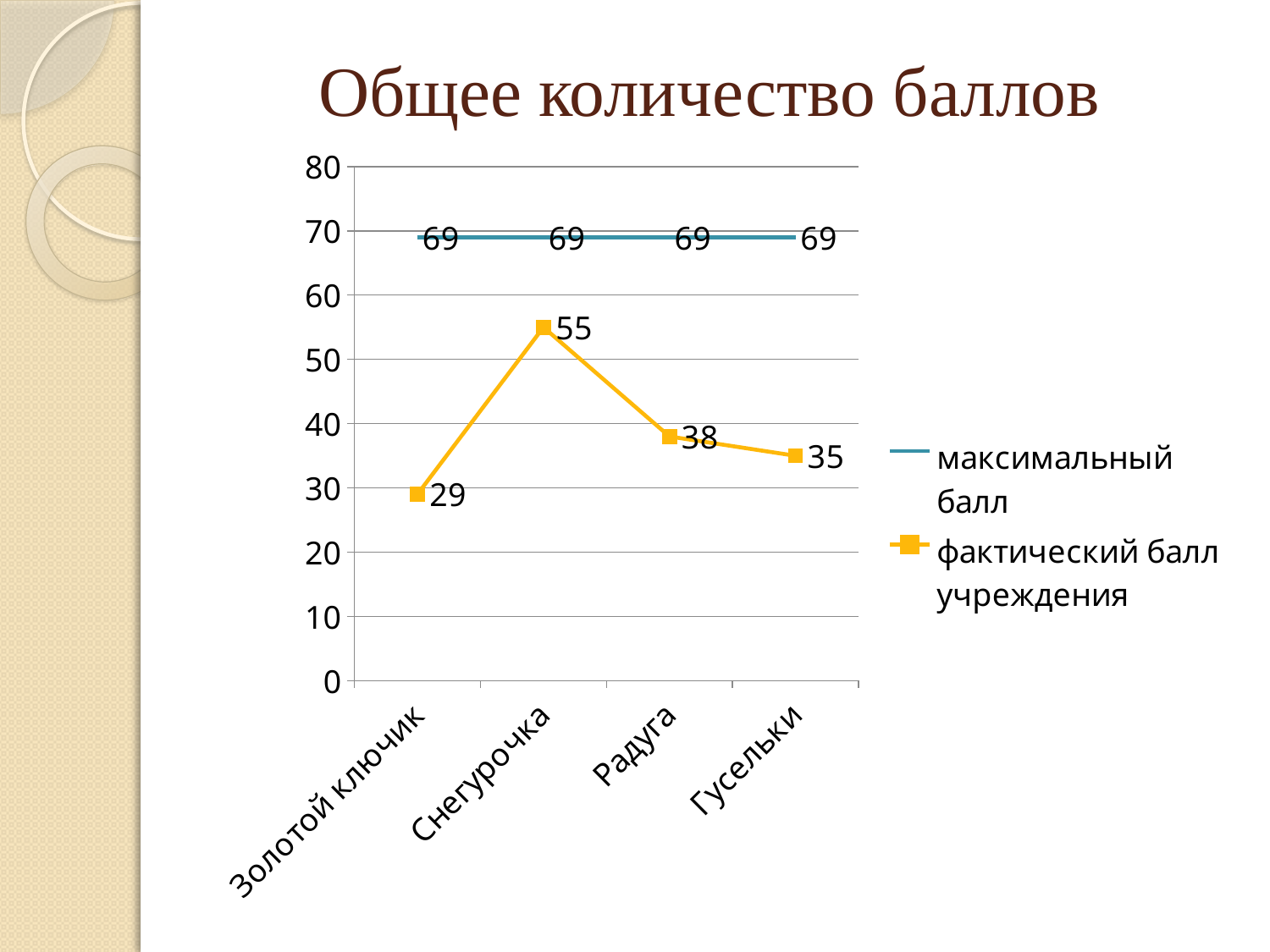
How many series does the legend list? 2 What is the фактический балл учреждения for Золотой ключик? 29 What is the фактический балл учреждения for Снегурочка? 55 How many categories are shown on the x axis? 4 What is the максимальный балл for Радуга? 69 What is the difference between the максимальный балл and the фактический балл учреждения for Гусельки? 34 What kind of chart is shown on the slide? line chart What is the difference between the фактический балл учреждения for Снегурочка and for Радуга? 17 Which category has the lowest фактический балл учреждения? Золотой ключик What is the title of the chart? Общее количество баллов Which category has the highest фактический балл учреждения? Снегурочка Which has a larger фактический балл учреждения, Радуга or Гусельки? Радуга